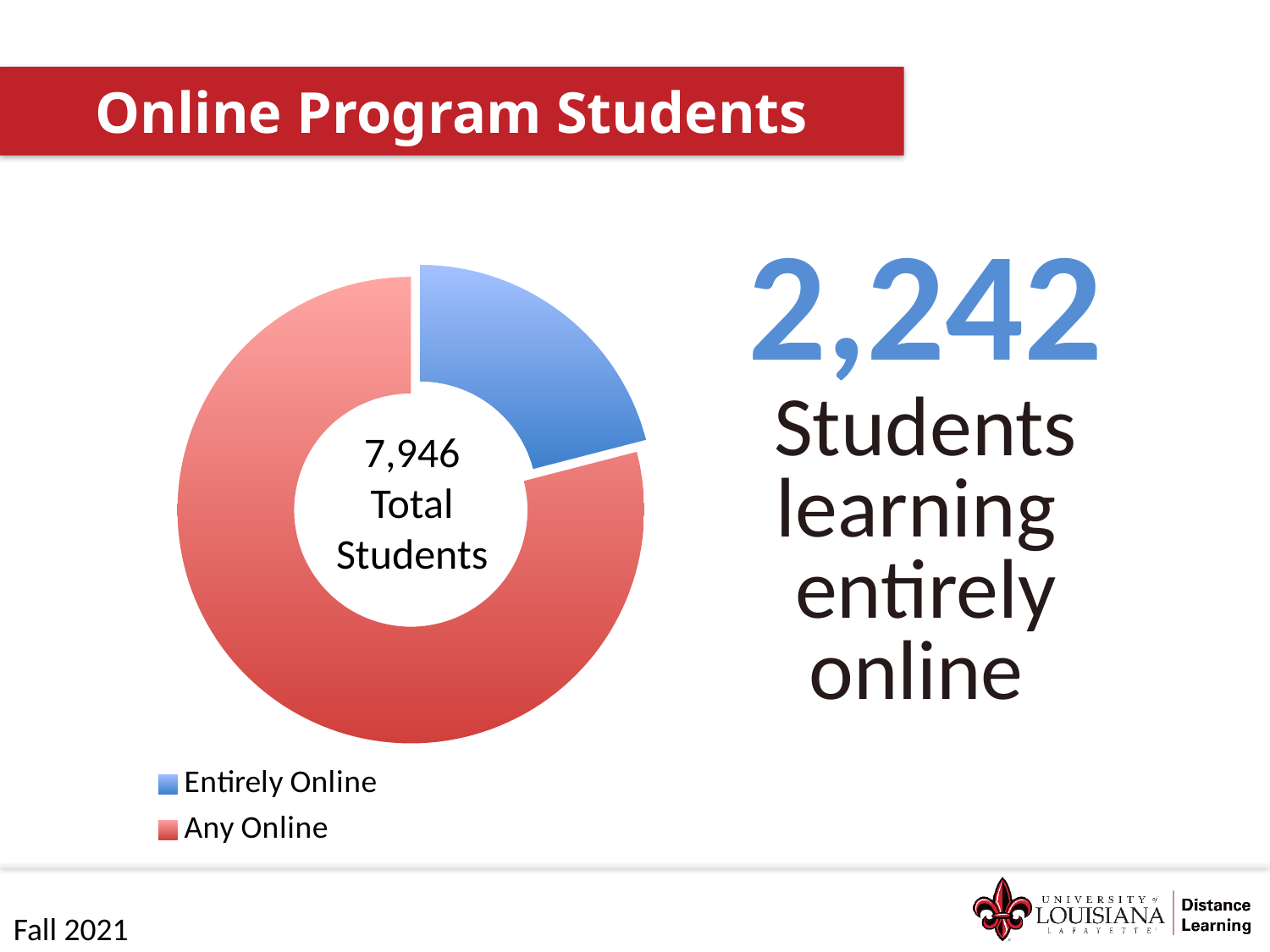
How many categories does the chart show? 2 What is the title of the slide containing the chart? Online Program Students How many entries does the legend list? 2 Which slice is larger, Entirely Online or Any Online? Any Online What is the total number of students shown in the centre of the chart? 7,946 How many students are learning entirely online according to the slide? 2,242 What kind of chart is shown on the slide? Doughnut (pie) chart Which category has the largest slice of the chart? Any Online Which category has the smallest slice of the chart? Entirely Online What colour represents Entirely Online in the chart? Blue